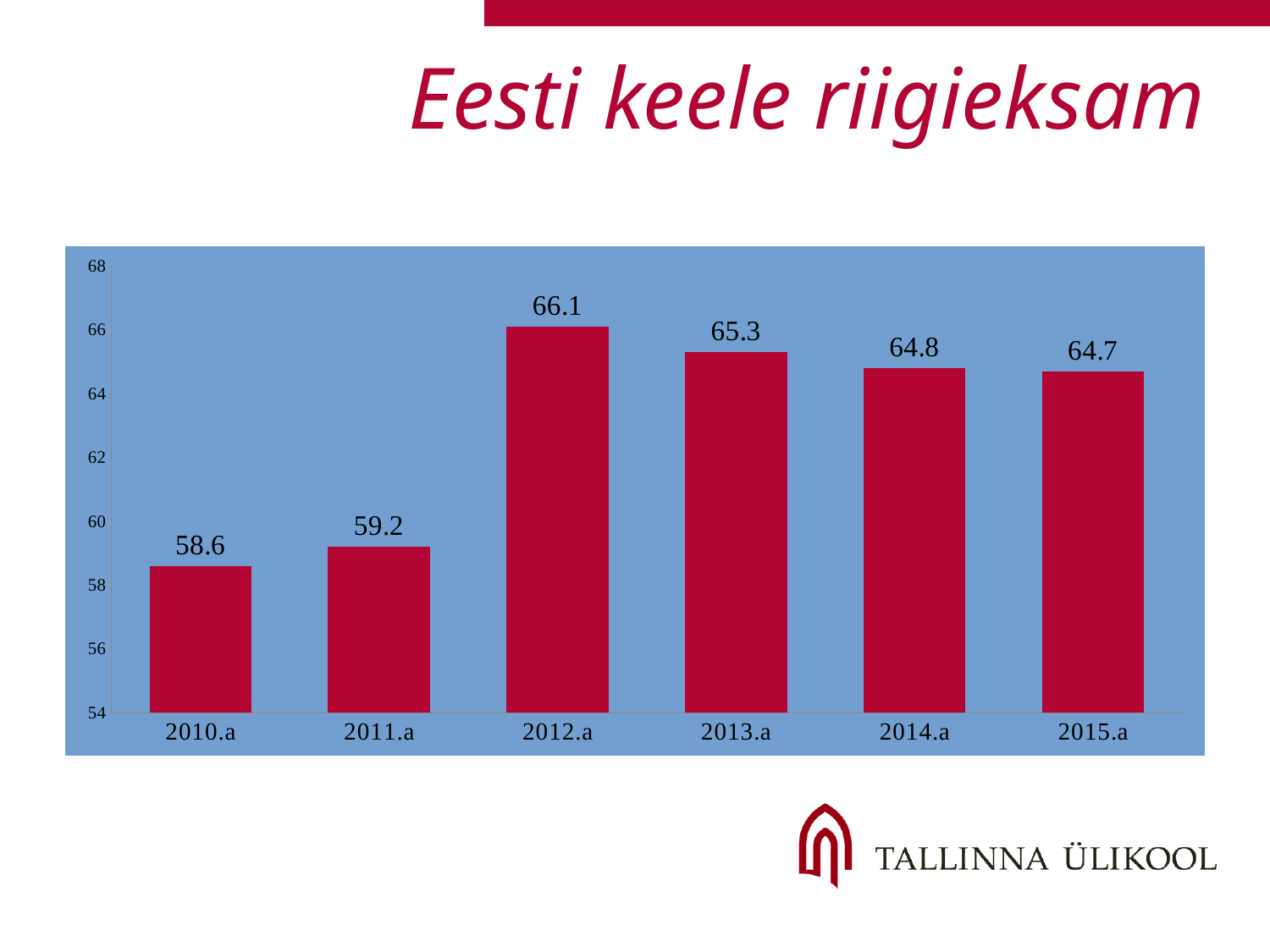
Which year has the lowest value? 2010.a What is the value for 2010.a? 58.6 What is the value for 2012.a? 66.1 Is the value for 2014.a greater or less than 62? greater What is the difference between the values for 2012.a and 2010.a? 7.5 Which is larger, the value for 2013.a or the value for 2011.a? 2013.a What is the title of the slide? Eesti keele riigieksam How many years are shown on the x axis? 6 What is the value for 2015.a? 64.7 What kind of chart is shown on the slide? bar chart What is the difference between the values for 2011.a and 2010.a? 0.6 Which year has the highest value? 2012.a